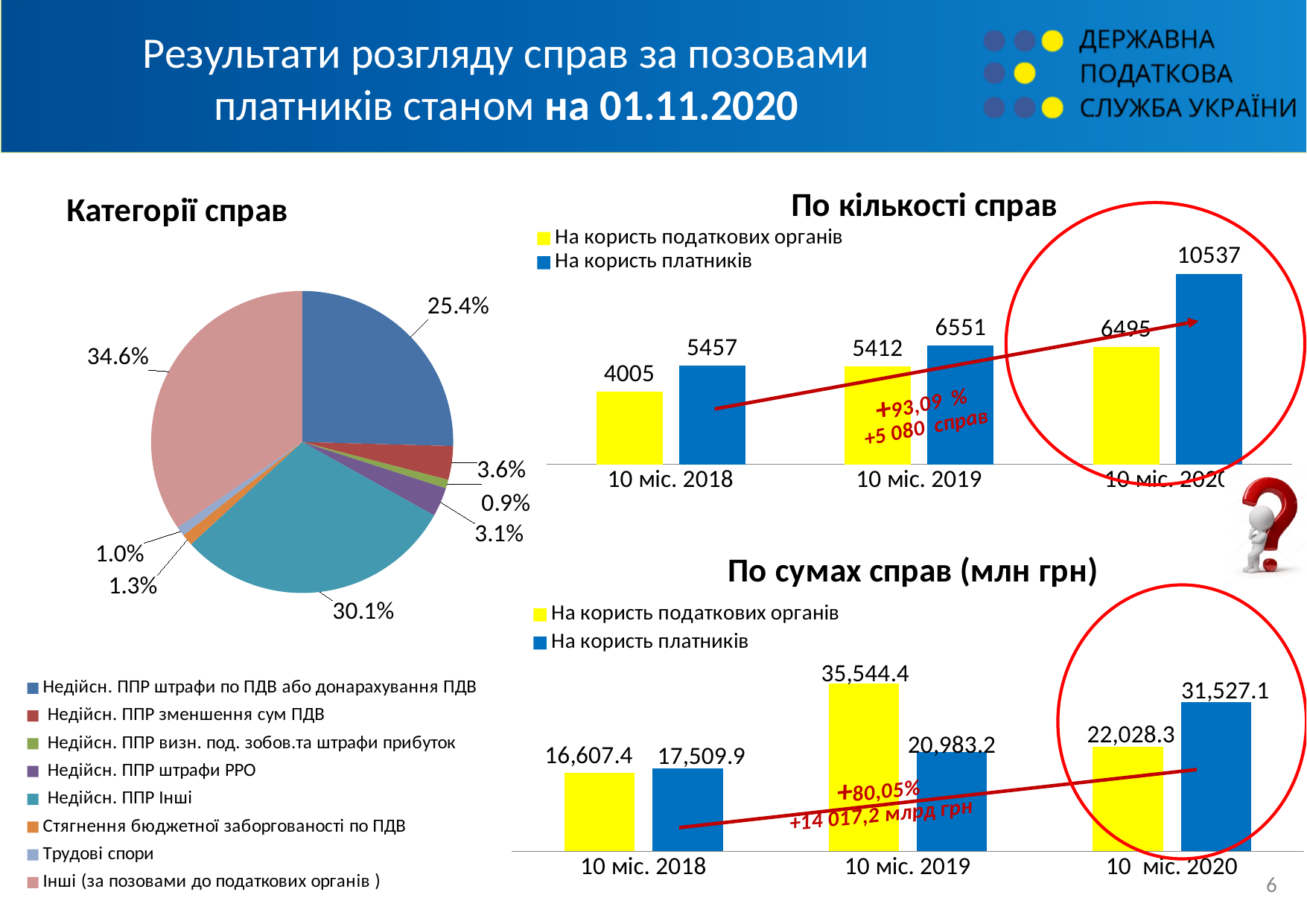
In the chart 'По кількості справ', what is the value for 'На користь платників' in 10 міс. 2020? 10537 In the chart 'По сумах справ (млн грн)', what is the value for 'На користь податкових органів' in 10 міс. 2019? 35,544.4 In the chart 'По кількості справ', what is the value for 'На користь податкових органів' in 10 міс. 2018? 4005 In the chart 'По сумах справ (млн грн)', which series has the larger value in 10 міс. 2020? На користь платників What kind of chart is 'Категорії справ'? pie chart In the chart 'Категорії справ', which category has the largest share? Інші (за позовами до податкових органів ) In the chart 'По кількості справ', what is the difference between the two series in 10 міс. 2019? 1139 In the chart 'Категорії справ', how many categories does the legend list? 8 In the chart 'Категорії справ', what share does 'Недійсн. ППР Інші' have? 30.1% In the chart 'По сумах справ (млн грн)', how many series does the legend list? 2 In the chart 'По кількості справ', does the value for 'На користь платників' rise or fall from 10 міс. 2018 to 10 міс. 2020? rise In the chart 'По сумах справ (млн грн)', which period has the highest value for 'На користь платників'? 10 міс. 2020